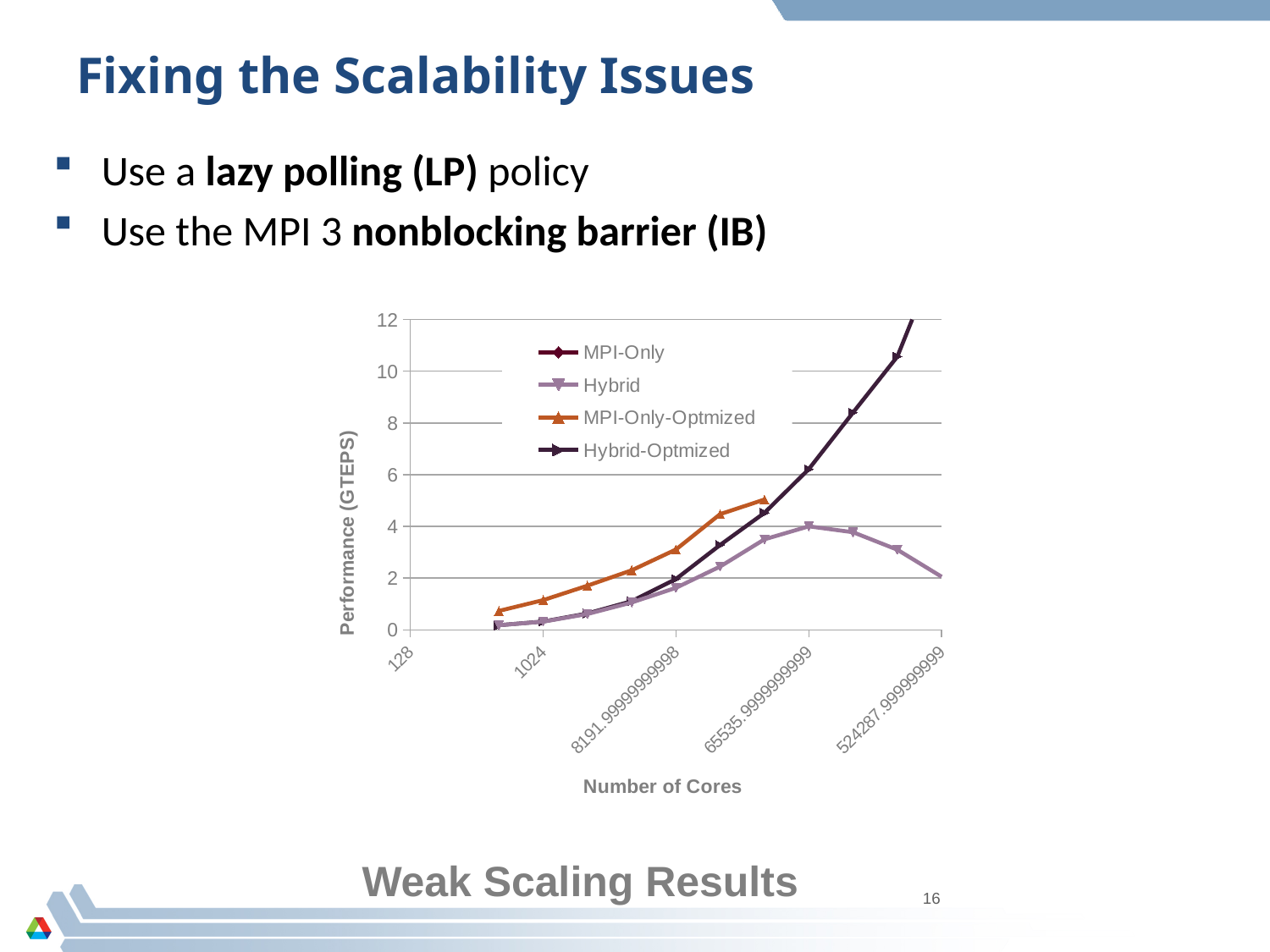
Which series reaches the highest performance value on the chart? Hybrid-Optmized At 8191.9999999998 cores, which series has the higher value, MPI-Only-Optmized or Hybrid-Optmized? MPI-Only-Optmized Is the MPI-Only-Optmized value at 1024 cores greater or less than 2? less What kind of chart is shown on the slide? line chart Is the Hybrid value at 8191.9999999998 cores greater or less than 2? less How many series does the chart legend list? 4 Is the Hybrid-Optmized value at 65535.9999999999 cores greater or less than 4? greater What is the title of the horizontal axis of the chart? Number of Cores At 65535.9999999999 cores, which series has the higher value, Hybrid-Optmized or Hybrid? Hybrid-Optmized Does the Hybrid series rise or fall between 65535.9999999999 and 524287.999999999 cores? fall What is the title of the vertical axis of the chart? Performance (GTEPS) Does the Hybrid-Optmized series rise or fall as the number of cores increases? rise